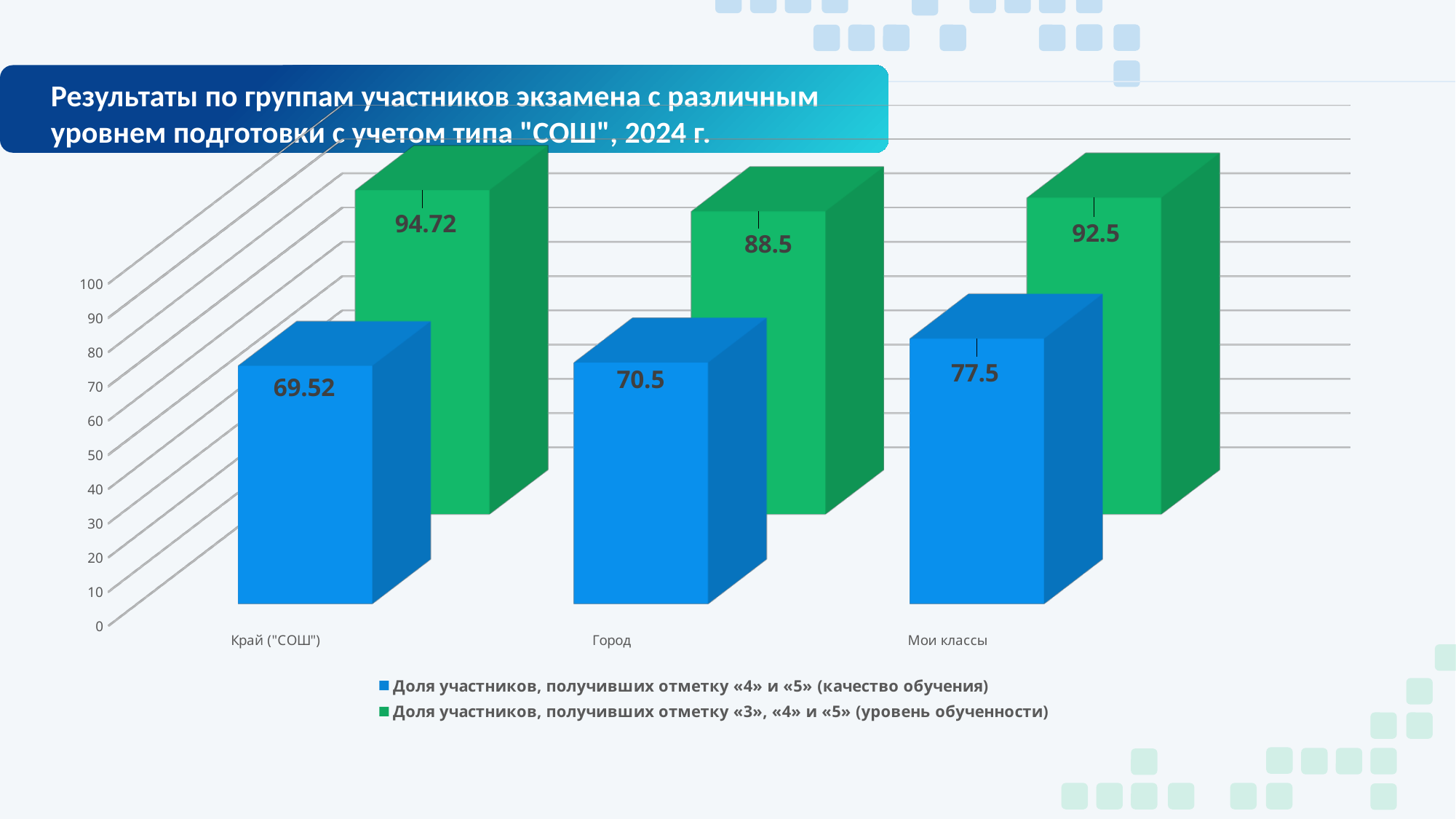
Which is larger in the series "Доля участников, получивших отметку «3», «4» и «5» (уровень обученности)": Город or Мои классы? Мои классы Which category has the lowest value in the series "Доля участников, получивших отметку «4» и «5» (качество обучения)"? Край ("СОШ") What is the value for Мои классы in the series "Доля участников, получивших отметку «4» и «5» (качество обучения)"? 77.5 Which category has the highest value in the series "Доля участников, получивших отметку «3», «4» и «5» (уровень обученности)"? Край ("СОШ") What is the value for Город in the series "Доля участников, получивших отметку «3», «4» и «5» (уровень обученности)"? 88.5 Which colour represents the series "Доля участников, получивших отметку «3», «4» и «5» (уровень обученности)"? Green What is the value for Край ("СОШ") in the series "Доля участников, получивших отметку «4» и «5» (качество обучения)"? 69.52 How many series does the legend list? 2 What is the difference between the values for Мои классы and Город in the series "Доля участников, получивших отметку «4» и «5» (качество обучения)"? 7 What is the difference between the two series values for Мои классы? 15 How many categories are shown on the x axis? 3 What kind of chart is shown on the slide? Bar chart